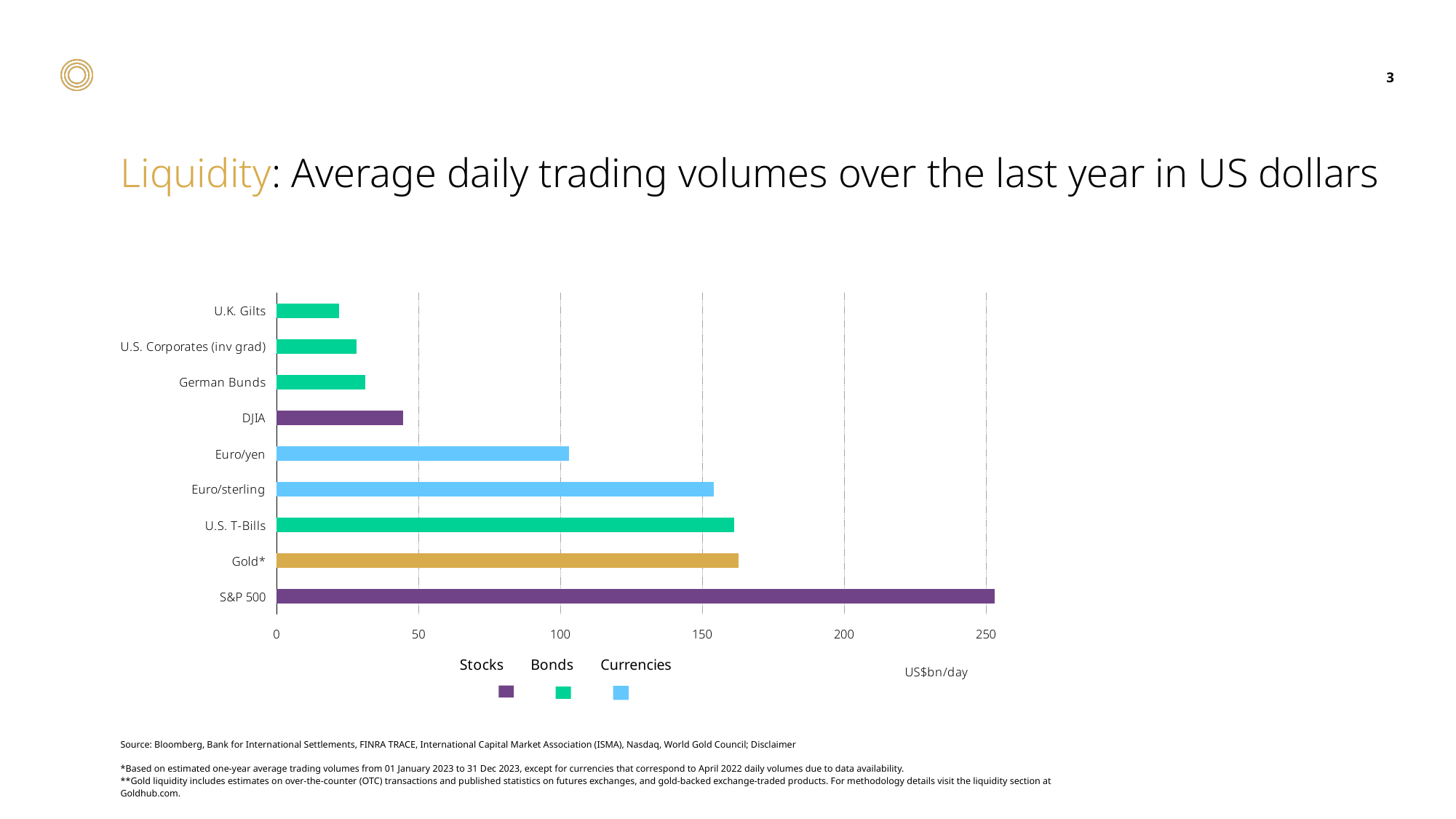
What kind of chart is shown on the slide? bar chart Is the value for S&P 500 greater or less than 200? greater Is the value for Euro/sterling greater or less than 200? less Is the value for DJIA greater or less than 50? less How many categories are plotted in the chart? 9 Which category has the highest average daily trading volume? S&P 500 Which is larger, the value for Euro/yen or the value for DJIA? Euro/yen How many series does the legend list? 3 Which category has the lowest average daily trading volume? U.K. Gilts What are the three series named in the legend? Stocks, Bonds, Currencies What unit is shown on the x axis of the chart? US$bn/day